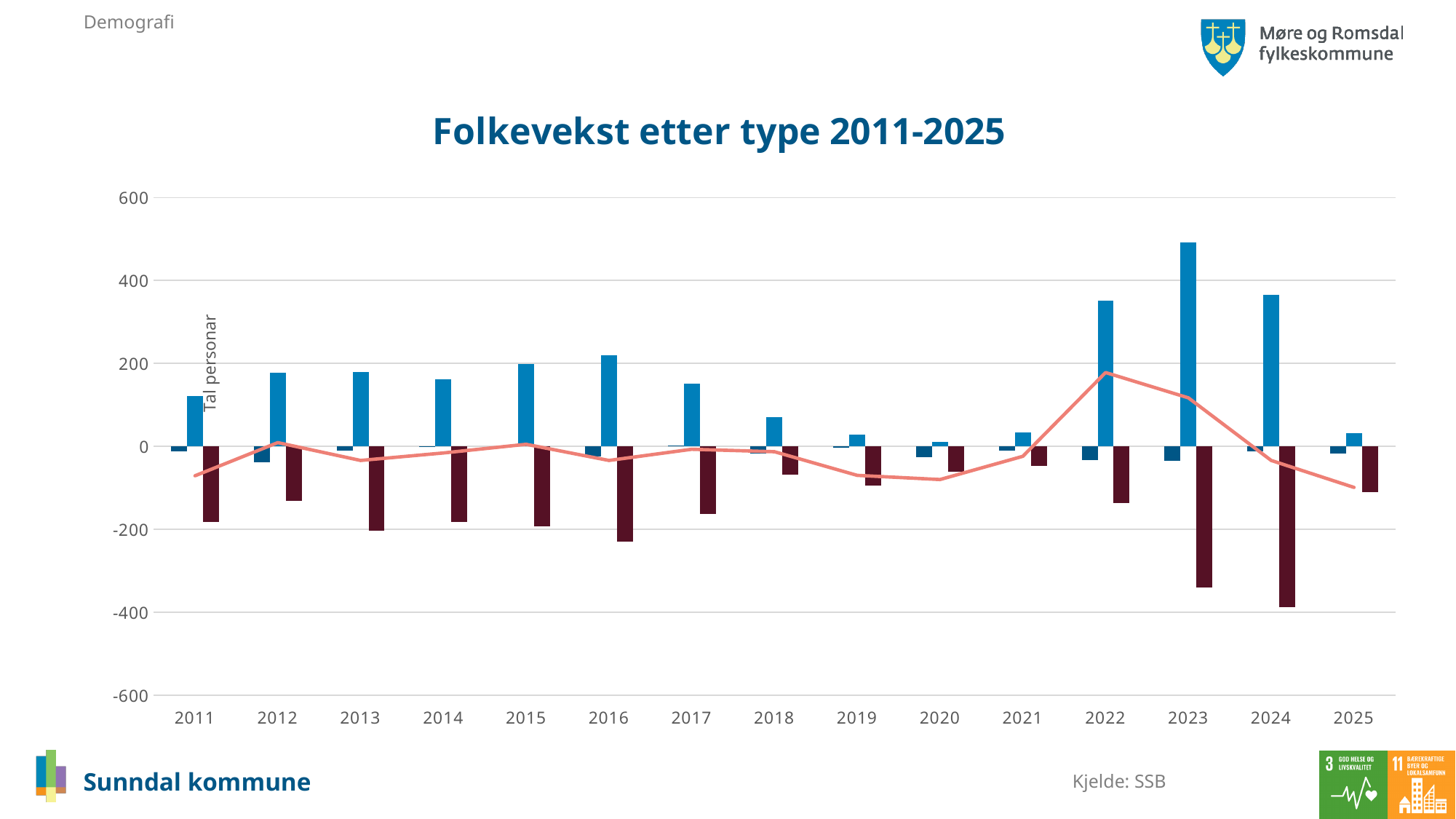
How many years are shown on the x axis of the chart? 15 In which year is the light blue bar the highest? 2023 What kind of chart is shown on the slide? A bar chart combined with a line In which year does the salmon-coloured line reach its highest point? 2022 What is the label on the vertical axis of the chart? Tal personar Which year has the lower dark red bar, 2012 or 2013? 2013 Is the dark red bar for 2024 greater or less than -200? less Is the light blue bar for 2019 greater or less than 100? less Is the light blue bar for 2023 greater or less than 400? greater In which year does the dark red bar reach its lowest value? 2024 Which year has the larger light blue bar, 2022 or 2023? 2023 What is the title of the chart? Folkevekst etter type 2011-2025